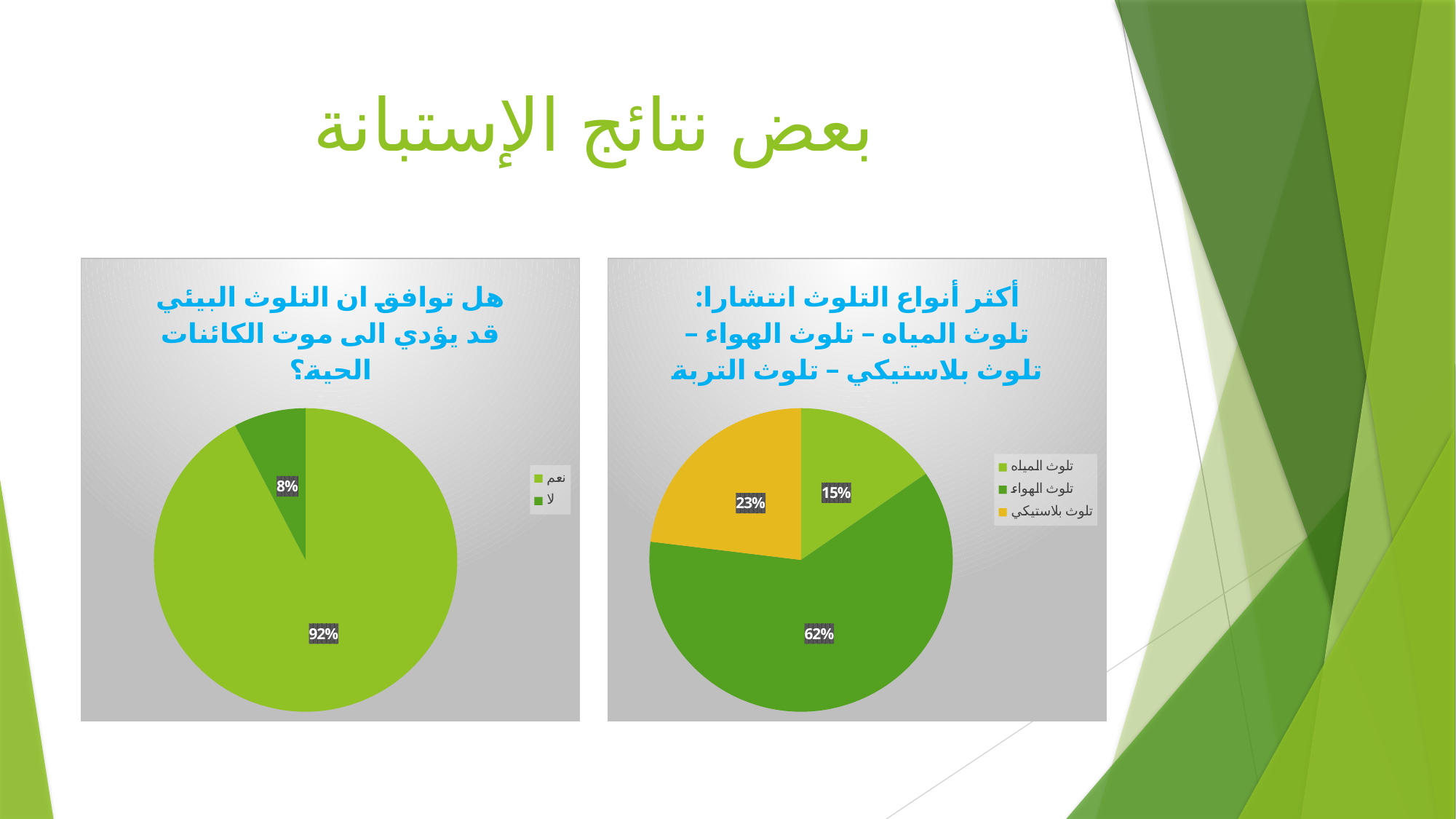
In the left chart (هل توافق ان التلوث البيئي قد يؤدي الى موت الكائنات الحية؟), what percentage answered نعم? 92% In the left chart, what is the difference in percentage points between نعم and لا? 84 What kind of chart is the left chart on the slide? Pie chart In the right chart, which category has the largest share? تلوث الهواء How many categories does the legend of the right chart list? 3 In the left chart (هل توافق ان التلوث البيئي قد يؤدي الى موت الكائنات الحية؟), what percentage answered لا? 8% In the right chart (أكثر أنواع التلوث انتشارا), what percentage is shown for تلوث الهواء? 62% In the right chart, which category has the smallest share? تلوث المياه How many entries does the legend of the left chart list? 2 In the right chart (أكثر أنواع التلوث انتشارا), what percentage is shown for تلوث المياه? 15% In the right chart (أكثر أنواع التلوث انتشارا), what percentage is shown for تلوث بلاستيكي? 23% In the right chart, which is larger: تلوث بلاستيكي or تلوث المياه? تلوث بلاستيكي